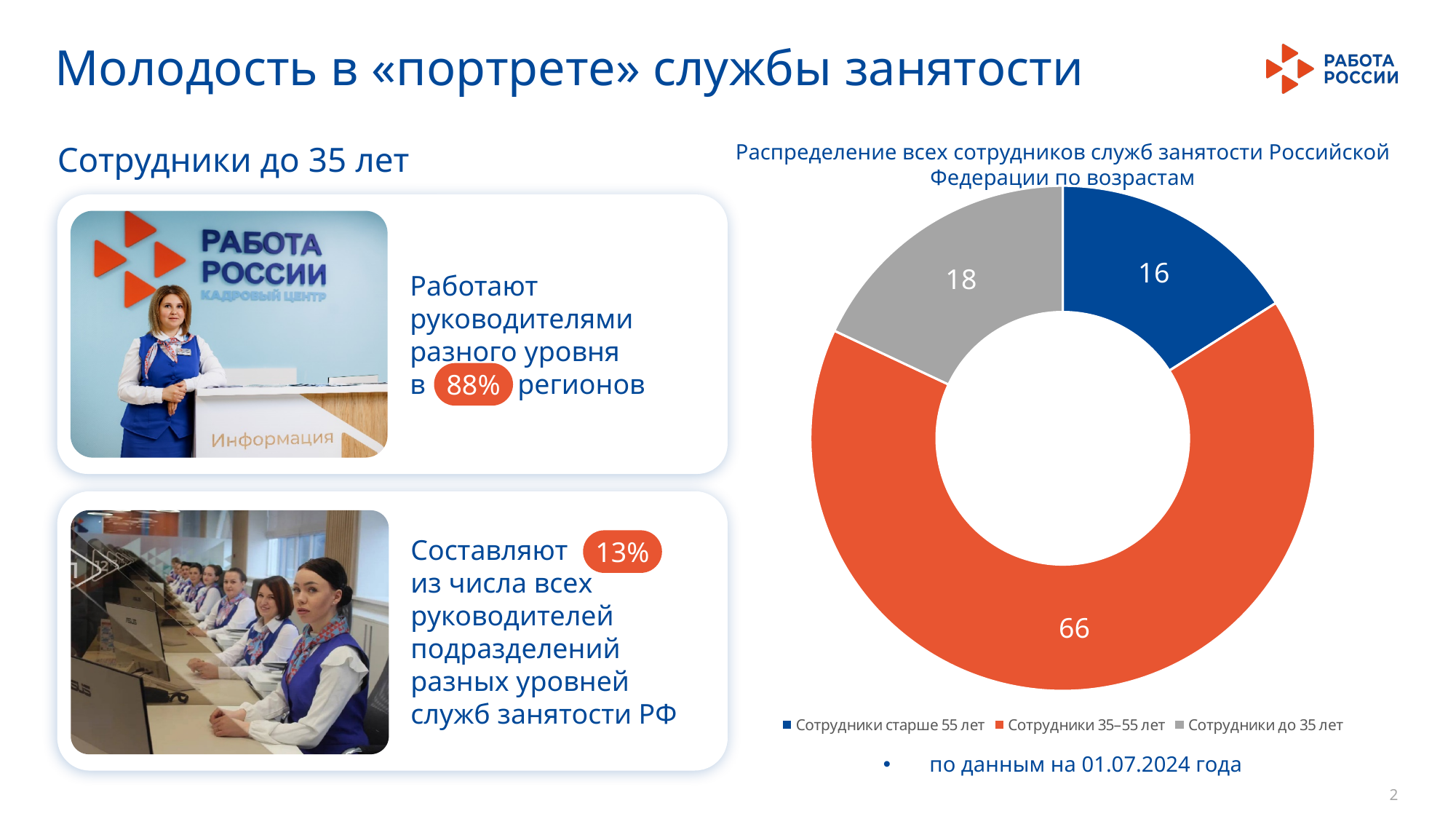
Which category has the smallest slice in the chart? Сотрудники старше 55 лет Which is larger: the value for Сотрудники до 35 лет or the value for Сотрудники старше 55 лет? Сотрудники до 35 лет Which colour represents Сотрудники до 35 лет in the chart? grey What value is shown for Сотрудники 35–55 лет in the chart? 66 What is the difference between the values for Сотрудники до 35 лет and Сотрудники старше 55 лет? 2 What value is shown for Сотрудники до 35 лет in the chart? 18 What kind of chart is shown on the slide? doughnut chart What is the title of the chart? Распределение всех сотрудников служб занятости Российской Федерации по возрастам What value is shown for Сотрудники старше 55 лет in the chart? 16 How many categories does the chart show? 3 Which category has the largest slice in the chart? Сотрудники 35–55 лет What is the difference between the values for Сотрудники 35–55 лет and Сотрудники до 35 лет? 48